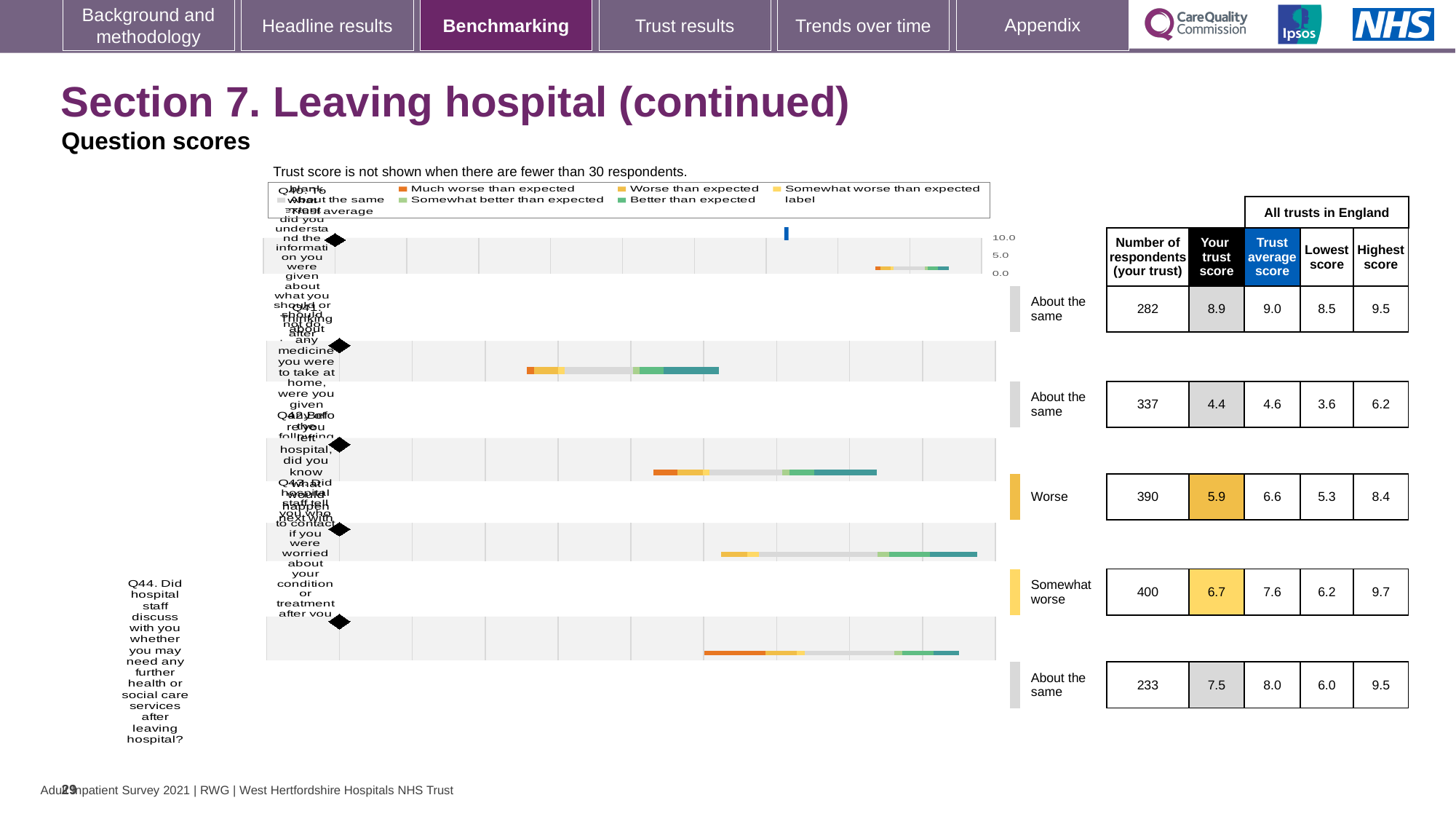
What kind of chart is used to show the question scores on this slide? bar chart For Q44, what is the difference between the highest score and the lowest score across all trusts in England? 3.5 Which rating row has the highest number of respondents (your trust)? Somewhat worse (400) How many question rows are plotted in the benchmarking chart? 5 How many respondents (your trust) are shown for Q44? 233 How many of the question rows are rated 'About the same'? 3 What is the trust average score for the question rated 'Somewhat worse'? 7.6 For Q44, which is larger: the trust's own score or the trust average score? Trust average score What is the 'Your trust score' for the question rated 'Worse'? 5.9 What is the 'Your trust score' for Q44 (discussing further health or social care services after leaving hospital)? 7.5 What is the trust average score for Q44? 8.0 What is the highest score across all trusts in England for Q44? 9.5